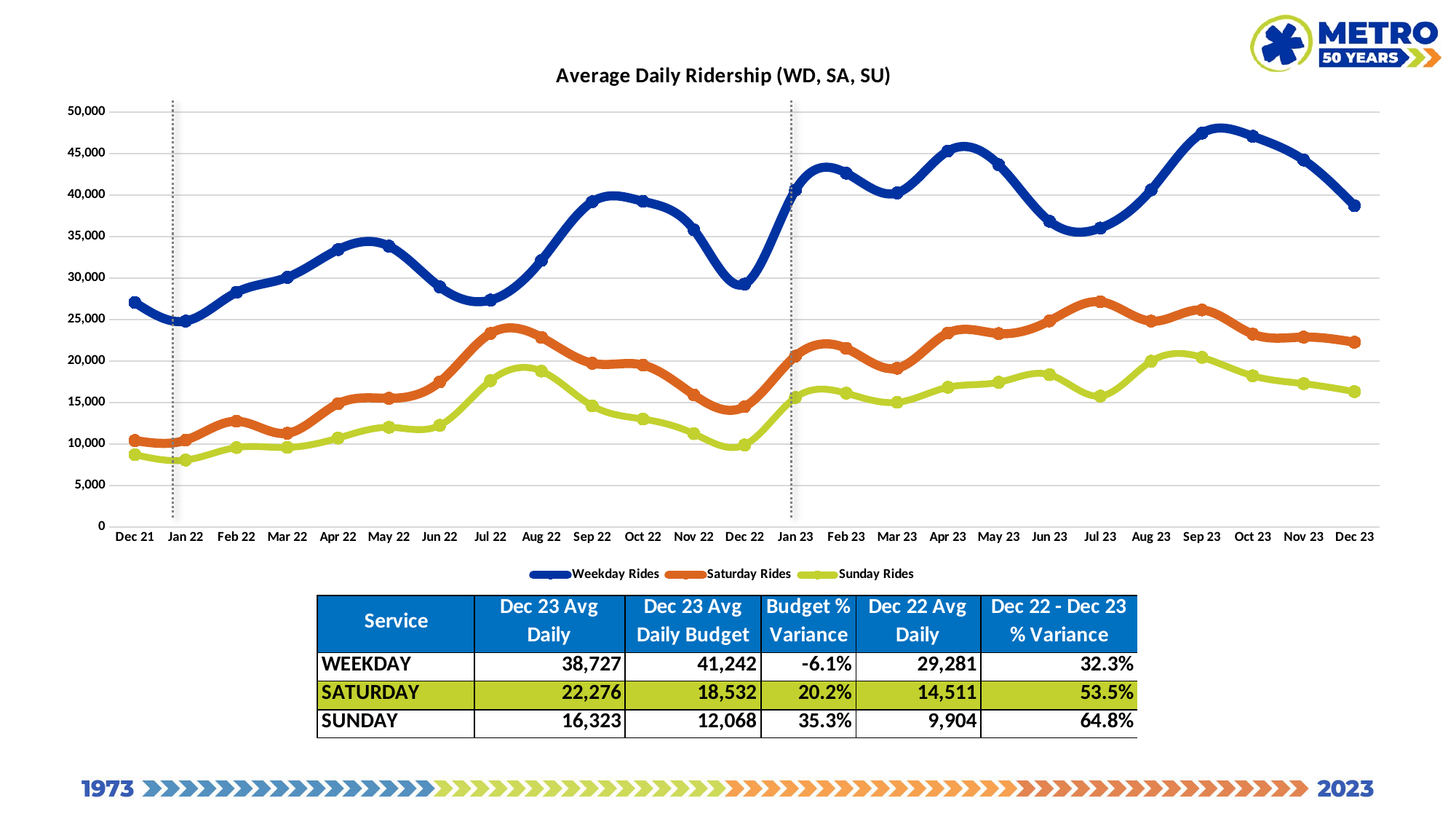
Is the value for Weekday Rides in Jul 22 greater or less than 30,000? less Is the value for Saturday Rides in Jul 23 greater or less than 25,000? greater In which month do Weekday Rides reach their highest point on the chart? Sep 23 According to the table, what is the Dec 22 average daily ridership for Sunday? 9,904 Is the value for Weekday Rides in Sep 23 greater or less than 45,000? greater Do Weekday Rides rise or fall from Sep 23 to Dec 23? fall According to the table, what is the Dec 23 average daily ridership for Weekday? 38,727 What kind of chart is shown on the slide? line chart How many series does the legend of the Average Daily Ridership chart list? 3 How many months are plotted along the x axis of the Average Daily Ridership chart? 25 In which month are Sunday Rides at their lowest point on the chart? Jan 22 Using the table values, what is the difference between Weekday average daily ridership in Dec 23 and Dec 22? 9,446